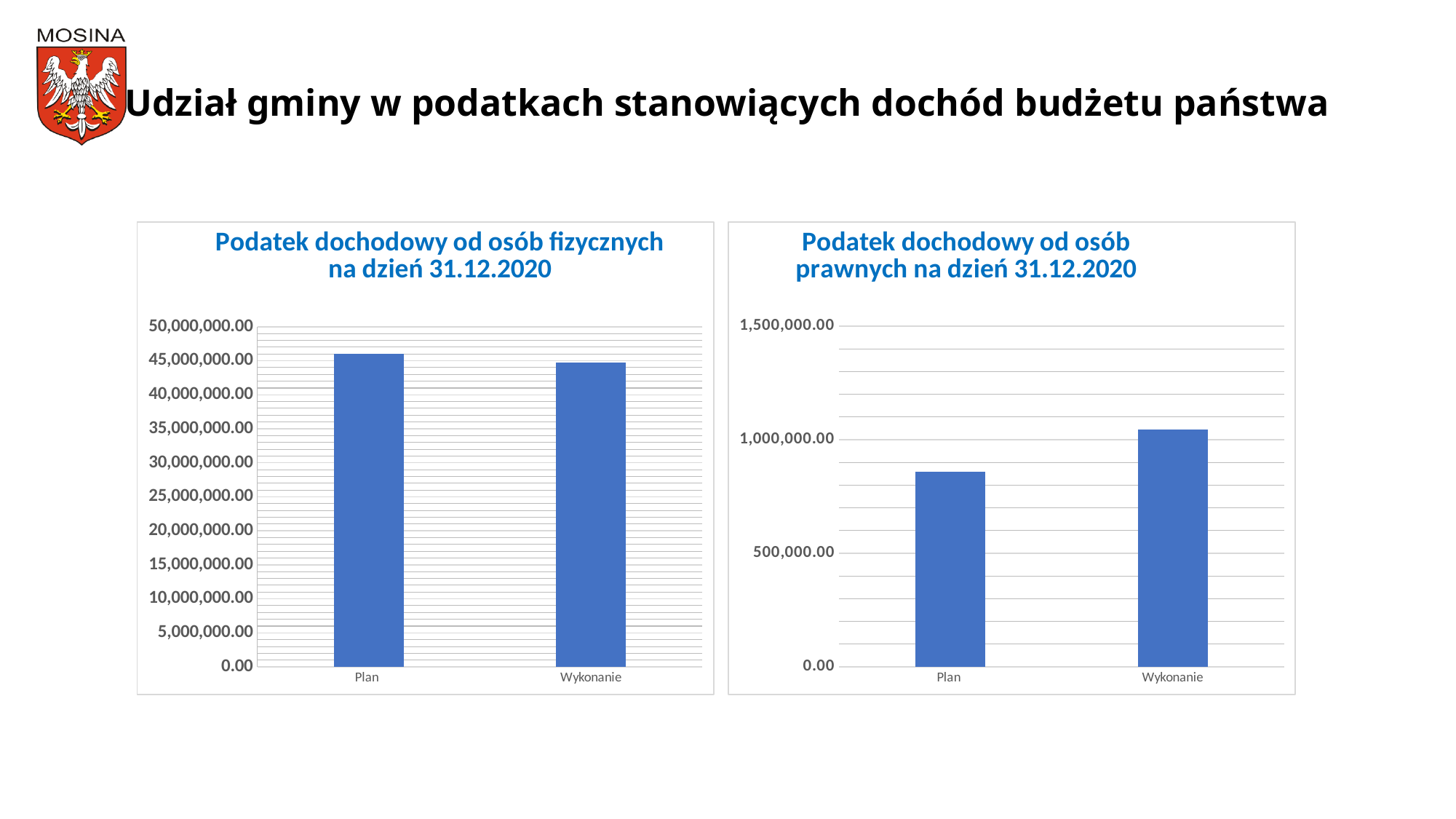
In the chart titled "Podatek dochodowy od osób fizycznych na dzień 31.12.2020", which category has the higher bar, Plan or Wykonanie? Plan In the right chart (Podatek dochodowy od osób prawnych), is the value for Wykonanie greater or less than 1,000,000.00? greater What is the highest value shown on the y axis of the right chart (Podatek dochodowy od osób prawnych)? 1,500,000.00 In the left chart (Podatek dochodowy od osób fizycznych), is the value for Wykonanie greater or less than 40,000,000.00? greater In the chart titled "Podatek dochodowy od osób prawnych na dzień 31.12.2020", which category has the higher bar, Plan or Wykonanie? Wykonanie In the left chart (Podatek dochodowy od osób fizycznych), is the value for Plan greater or less than 40,000,000.00? greater What kind of chart is the right chart (Podatek dochodowy od osób prawnych)? bar chart In the left chart (Podatek dochodowy od osób fizycznych), which category has the lowest bar? Wykonanie In the right chart (Podatek dochodowy od osób prawnych), which category has the highest bar? Wykonanie How many categories are shown on the x axis of the left chart (Podatek dochodowy od osób fizycznych)? 2